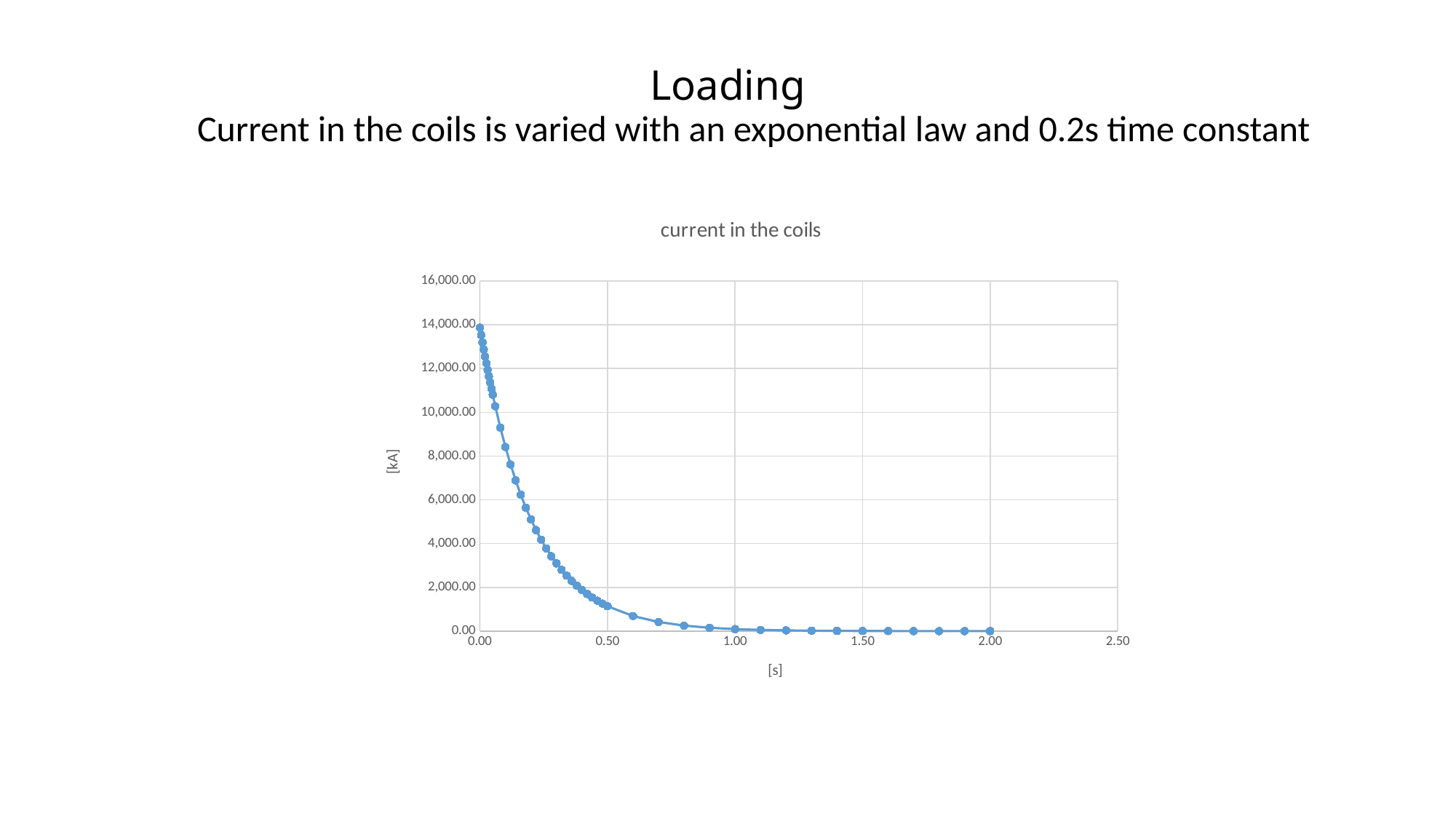
Is the value of the current at time 0.00 greater or less than 16,000.00? less Do the values of the current rise or fall as time increases along the x axis? fall Which is larger, the current at time 0.00 or the current at time 1.00? 0.00 At what time on the x axis does the last plotted point occur? 2.00 Is the value of the current at time 0.50 greater or less than 2,000.00? less What kind of chart is shown on the slide? line chart What is the title of the chart? current in the coils At which time on the x axis is the current in the coils highest? 0.00 Is the value of the current at time 1.00 greater or less than 2,000.00? less What is the label on the y axis of the chart? [kA]